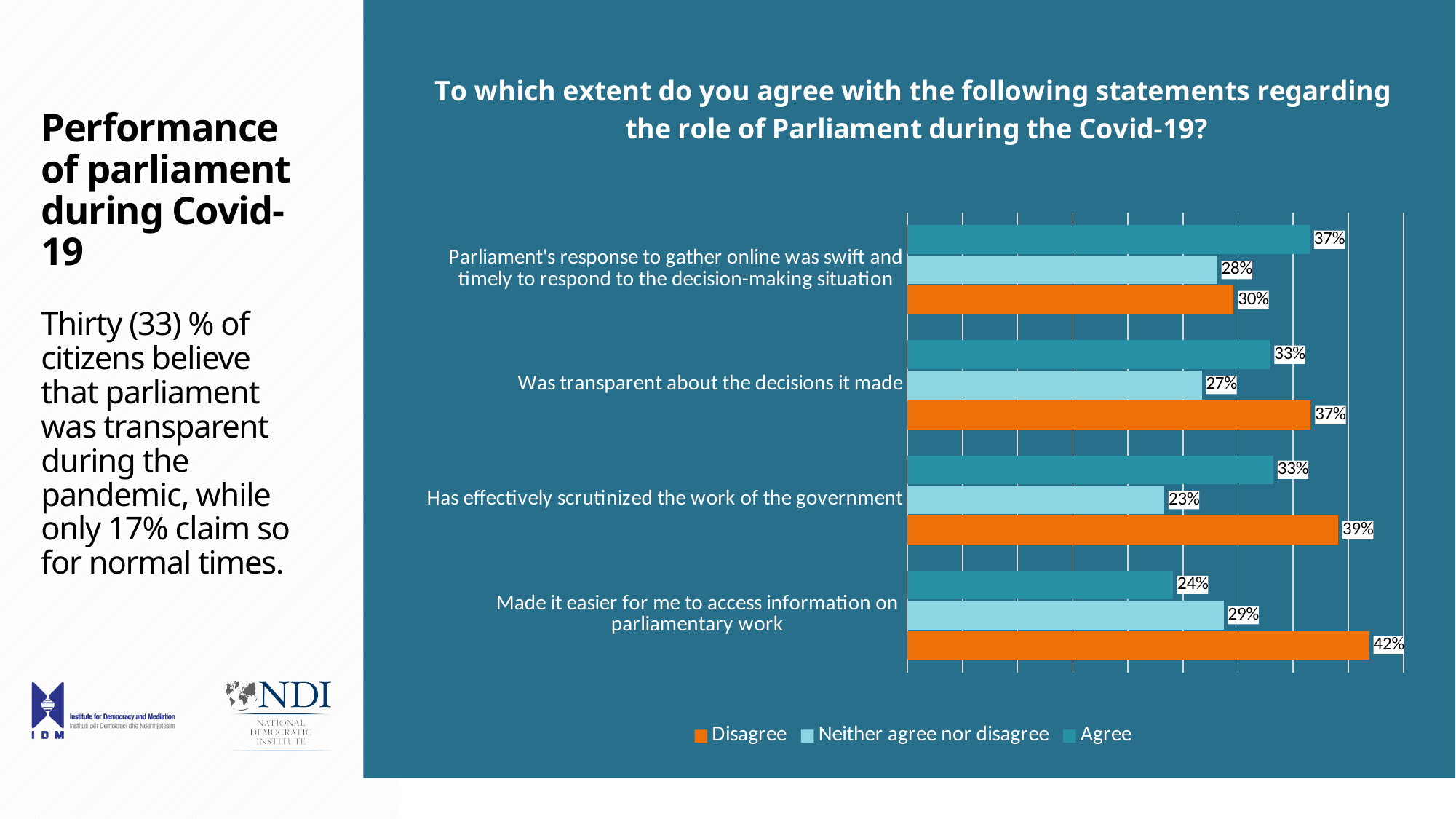
What percentage of respondents neither agree nor disagree that Parliament has effectively scrutinized the work of the government? 23% For which statement is the Agree value the lowest? Made it easier for me to access information on parliamentary work For which statement is the Disagree value the highest? Made it easier for me to access information on parliamentary work Which series is shown in orange in the legend? Disagree For 'Parliament's response to gather online was swift and timely', which is larger: the Agree value or the Disagree value? Agree What is the difference between the Disagree and Agree values for 'Has effectively scrutinized the work of the government'? 6% How many statements (categories) are shown in the chart? 4 What percentage of respondents disagree that Parliament made it easier for them to access information on parliamentary work? 42% What kind of chart is shown on the slide? bar chart What percentage of respondents disagree that Parliament was transparent about the decisions it made? 37% How many series does the legend list? 3 What percentage of respondents agree that Parliament's response to gather online was swift and timely? 37%